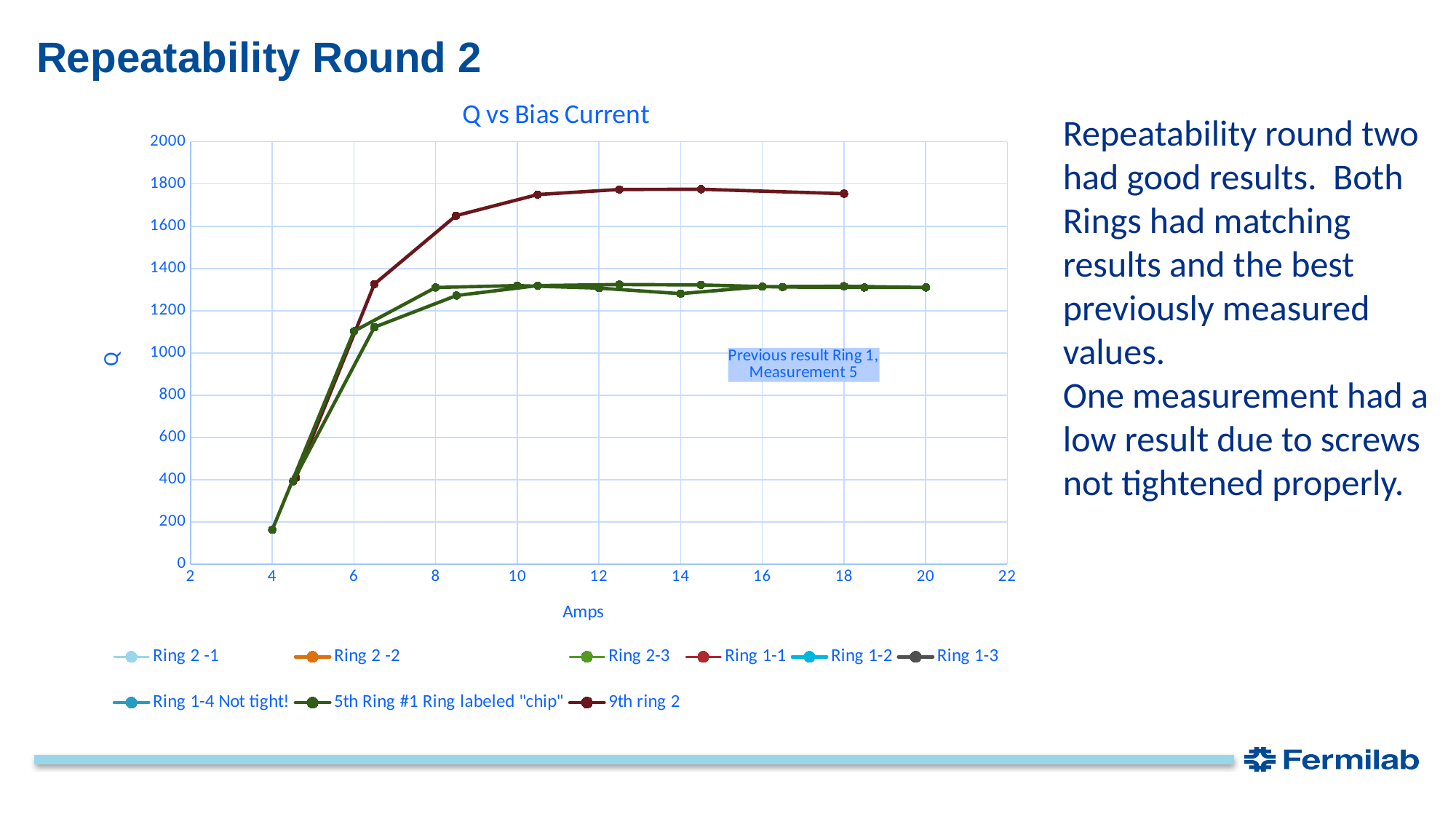
Do the Q values rise or fall as Amps increase from 4 to 8? rise What kind of chart is shown on the slide? line chart What is the label of the x axis? Amps Is the lowest plotted value, at 4 Amps, greater or less than 400? less What is the title of the chart? Q vs Bias Current Is the value of the dark red line at 18 Amps greater or less than 1600? greater Which colour line reaches the highest Q values on the chart? dark red What is the highest value shown on the y axis? 2000 How many series does the chart legend list? 9 What does the text annotation inside the plot area say? Previous result Ring 1, Measurement 5